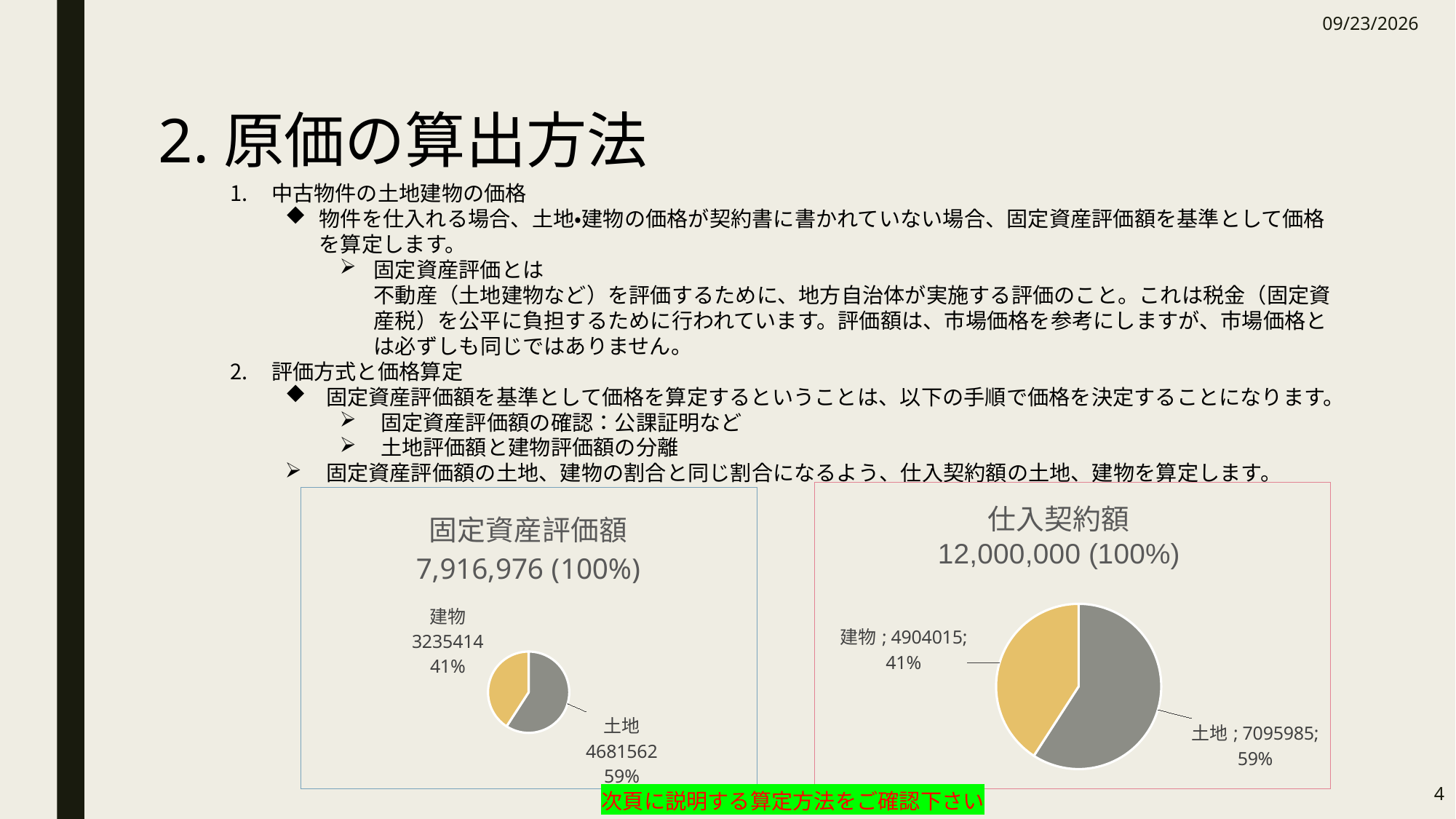
In the 仕入契約額 chart, what is the value for 建物? 4904015 What total is shown in the title of the 仕入契約額 chart? 12,000,000 (100%) How many slices does the 固定資産評価額 pie chart have? 2 What type of chart is used in the 固定資産評価額 chart? pie chart In the 固定資産評価額 chart, which slice is the smallest? 建物 In the 仕入契約額 chart, what is the difference between the 土地 and 建物 values? 2191970 In the 固定資産評価額 chart, what share of the pie does 土地 take? 59% In the 仕入契約額 chart, what share of the pie does 建物 take? 41% In the 仕入契約額 chart, what is the value for 土地? 7095985 In the 固定資産評価額 chart, what is the value for 建物? 3235414 In the 固定資産評価額 chart, what is the value for 土地? 4681562 In the 仕入契約額 chart, which slice is the largest? 土地